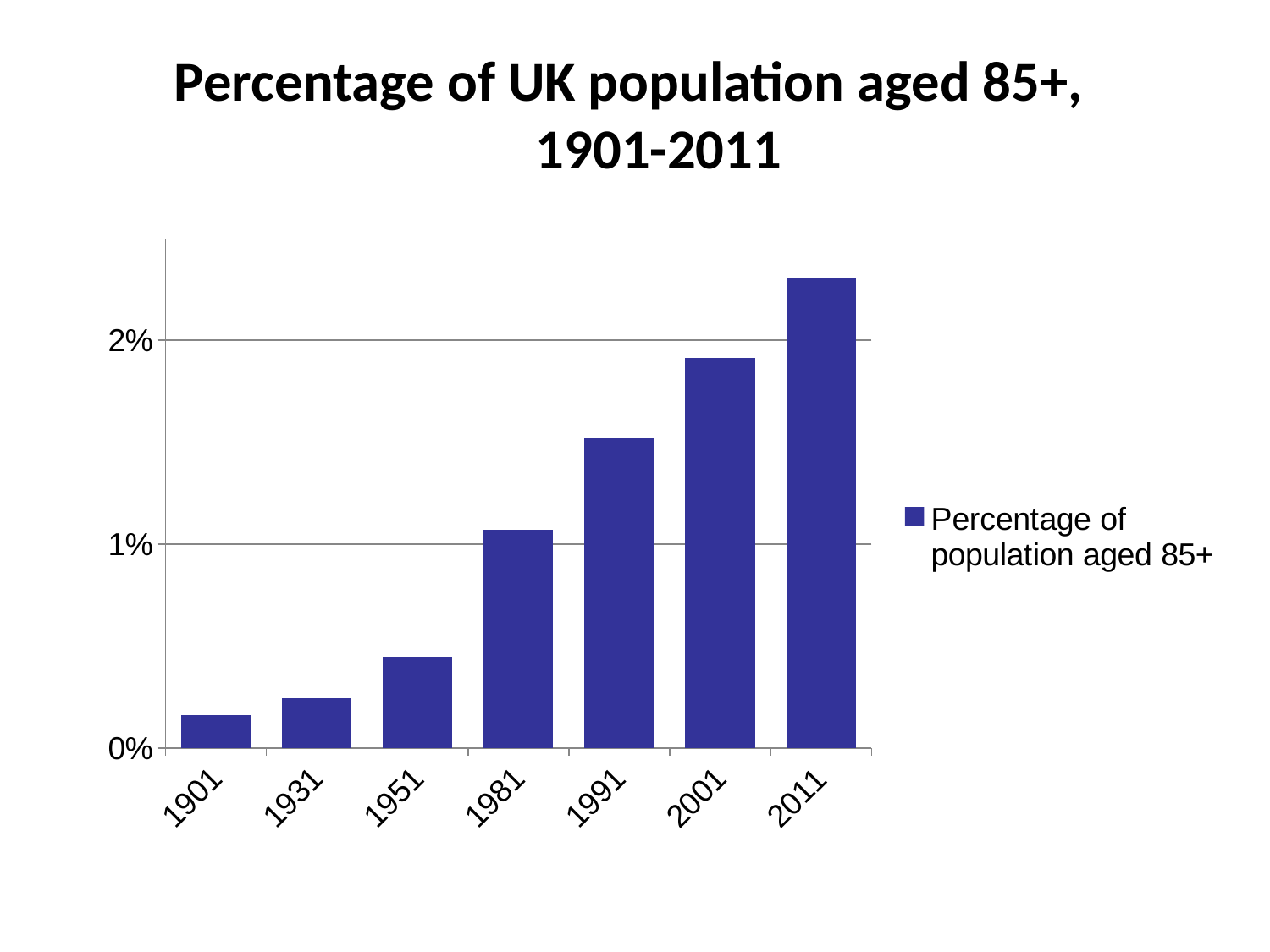
Is the value for 2001 greater or less than 2%? less Which year has the highest percentage of population aged 85+? 2011 How many series does the legend list? 1 What is the title of the chart? Percentage of UK population aged 85+, 1901-2011 Do the values rise or fall from 1901 to 2011? rise Which year has the lowest percentage of population aged 85+? 1901 Is the value for 1991 greater or less than 1%? greater Is the value for 2011 greater or less than 2%? greater What type of chart is shown on the slide? bar chart How many years are shown on the x axis? 7 Which year has a larger value, 1981 or 2001? 2001